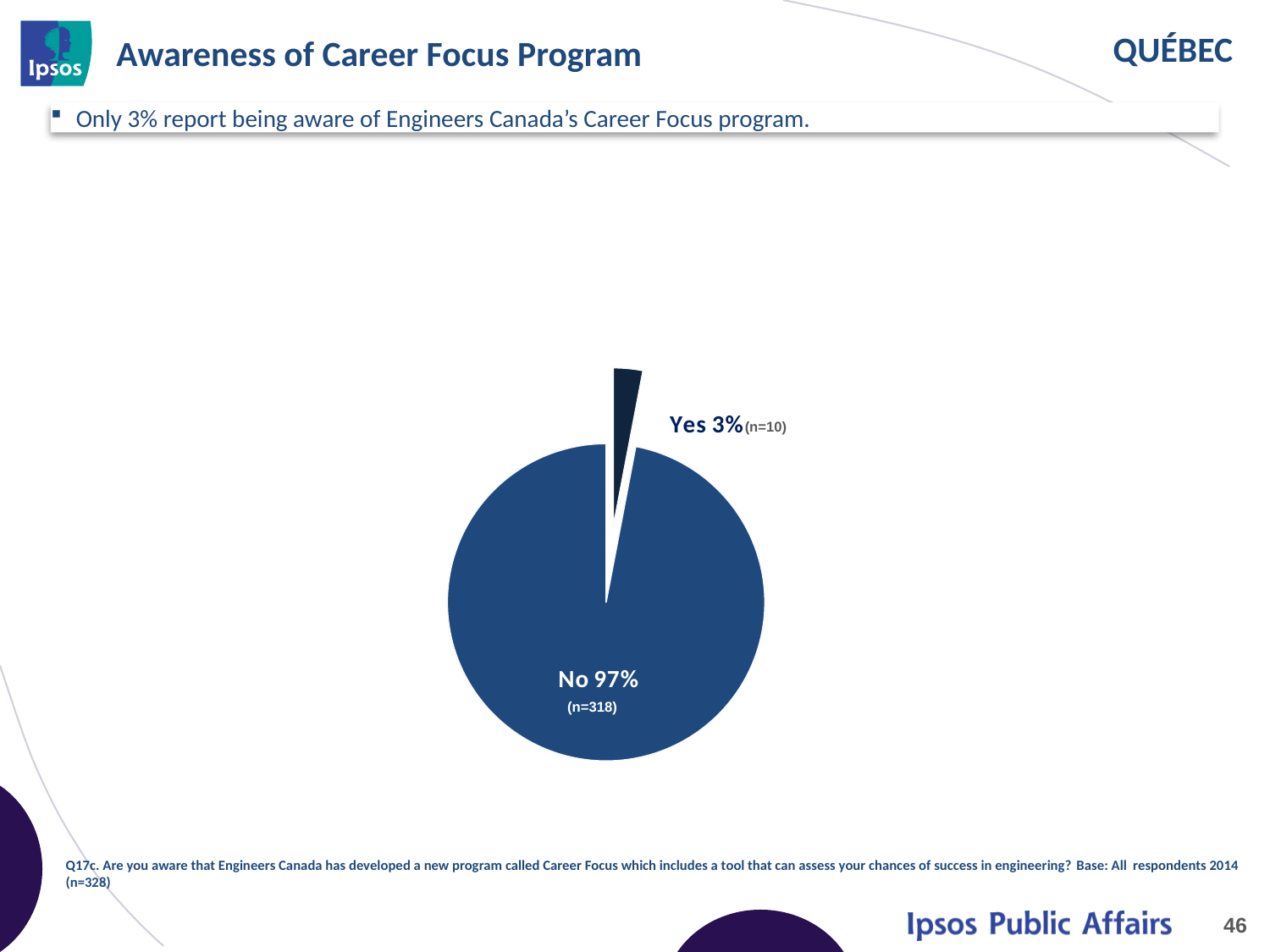
How many slices does the pie chart have? 2 What percentage of respondents answered "No"? 97% Which slice is larger, "Yes" or "No"? No What kind of chart is shown on the slide? pie chart What is the difference in percentage points between the "No" and "Yes" slices? 94 What is the total base size (n) of respondents shown for the chart? 328 How many respondents (n) are in the "No" slice? 318 Which response has the smallest share of the pie? Yes Which response has the largest share of the pie? No How many respondents (n) are in the "Yes" slice? 10 What percentage of respondents answered "Yes" to being aware of the Career Focus program? 3% What is the title of the slide containing the chart? Awareness of Career Focus Program